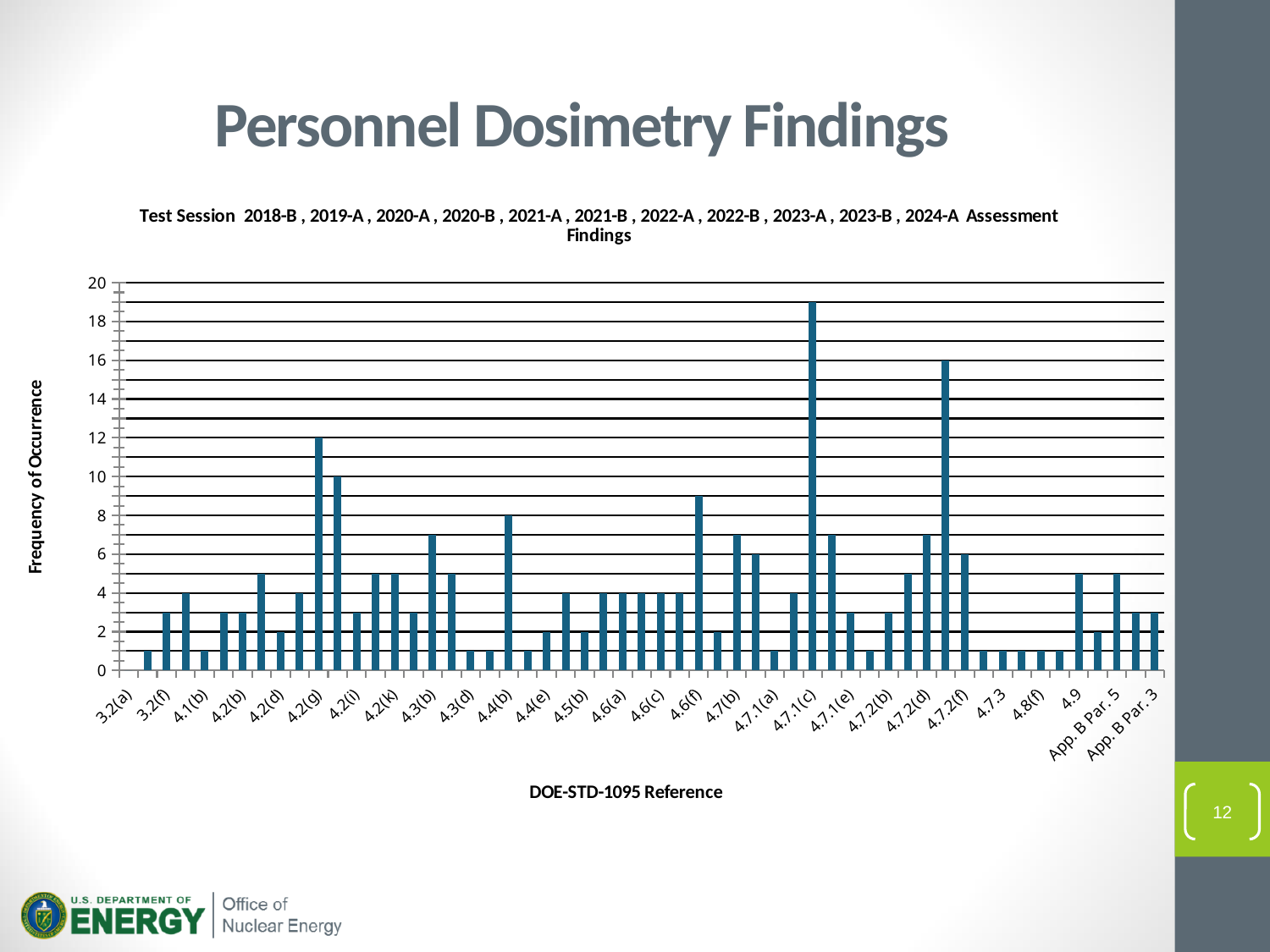
What is the difference between the frequency of occurrence for 4.2(g) and for 4.4(b)? 4 What is the frequency of occurrence for reference 4.4(b)? 8 What kind of chart is shown on the slide? bar chart Is the value for 4.6(f) greater or less than 8? greater Which has a higher frequency of occurrence, 4.2(g) or 4.4(b)? 4.2(g) What is the title of the vertical axis? Frequency of Occurrence Which DOE-STD-1095 reference has the highest frequency of occurrence? 4.7.1(c) What is the title of the horizontal axis? DOE-STD-1095 Reference Is the value for 4.3(d) greater or less than 2? less Is the value for 4.7.1(c) greater or less than 18? greater What is the frequency of occurrence for reference 4.2(g)? 12